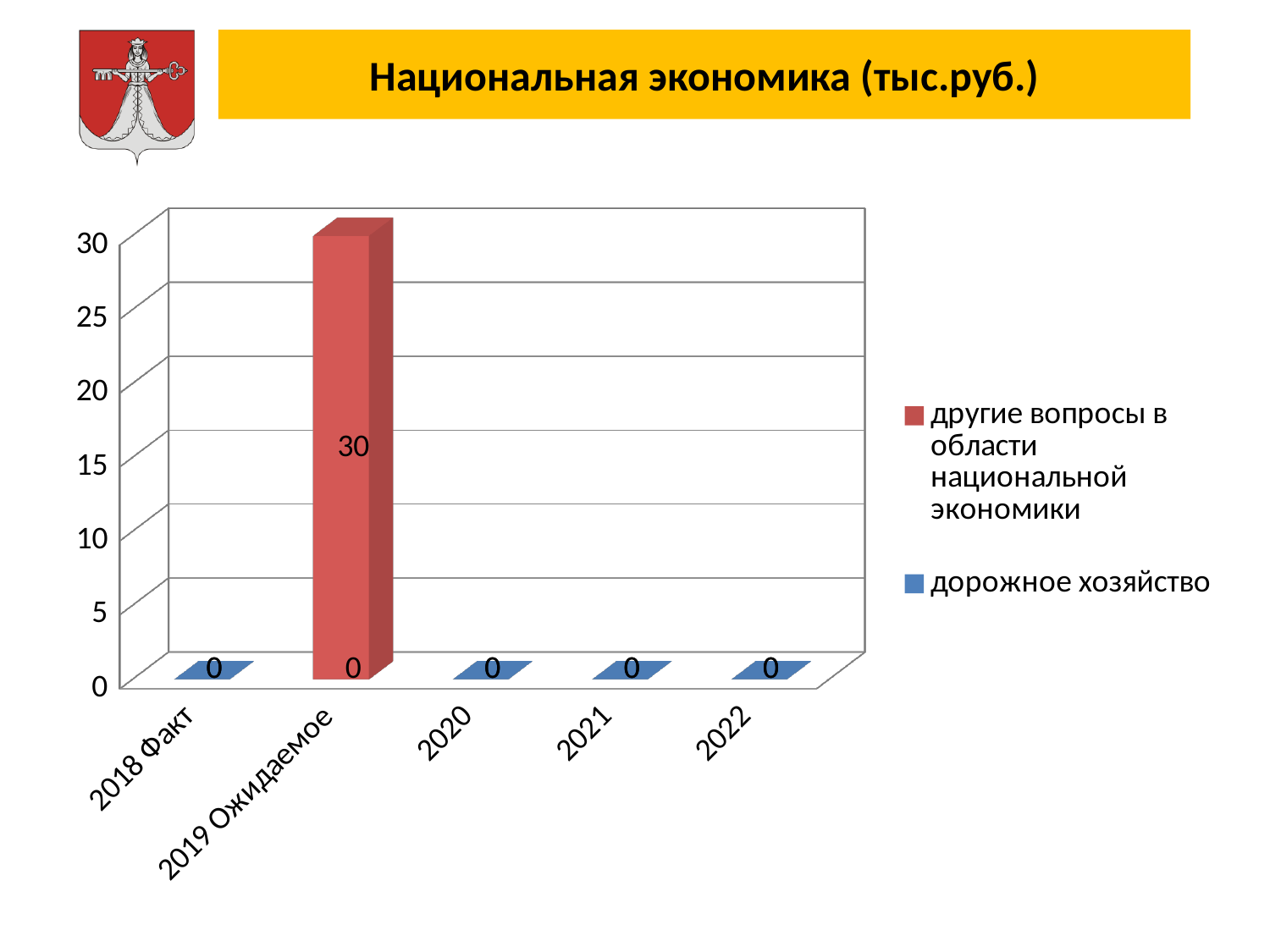
What type of chart is shown on the slide? bar chart How many series does the legend list? 2 What is the value for 'дорожное хозяйство' in 2018 Факт? 0 What is the value for 'другие вопросы в области национальной экономики' in 2019 Ожидаемое? 30 What is the difference between 'другие вопросы в области национальной экономики' and 'дорожное хозяйство' in 2019 Ожидаемое? 30 What is the value for 'дорожное хозяйство' in 2019 Ожидаемое? 0 What is the chart's title? Национальная экономика (тыс.руб.) What is the value for 'дорожное хозяйство' in 2022? 0 Which category has the highest value for 'другие вопросы в области национальной экономики'? 2019 Ожидаемое How many categories are shown on the x axis? 5 Which colour represents 'дорожное хозяйство' in the legend? blue Which is larger in 2019 Ожидаемое: 'другие вопросы в области национальной экономики' or 'дорожное хозяйство'? другие вопросы в области национальной экономики